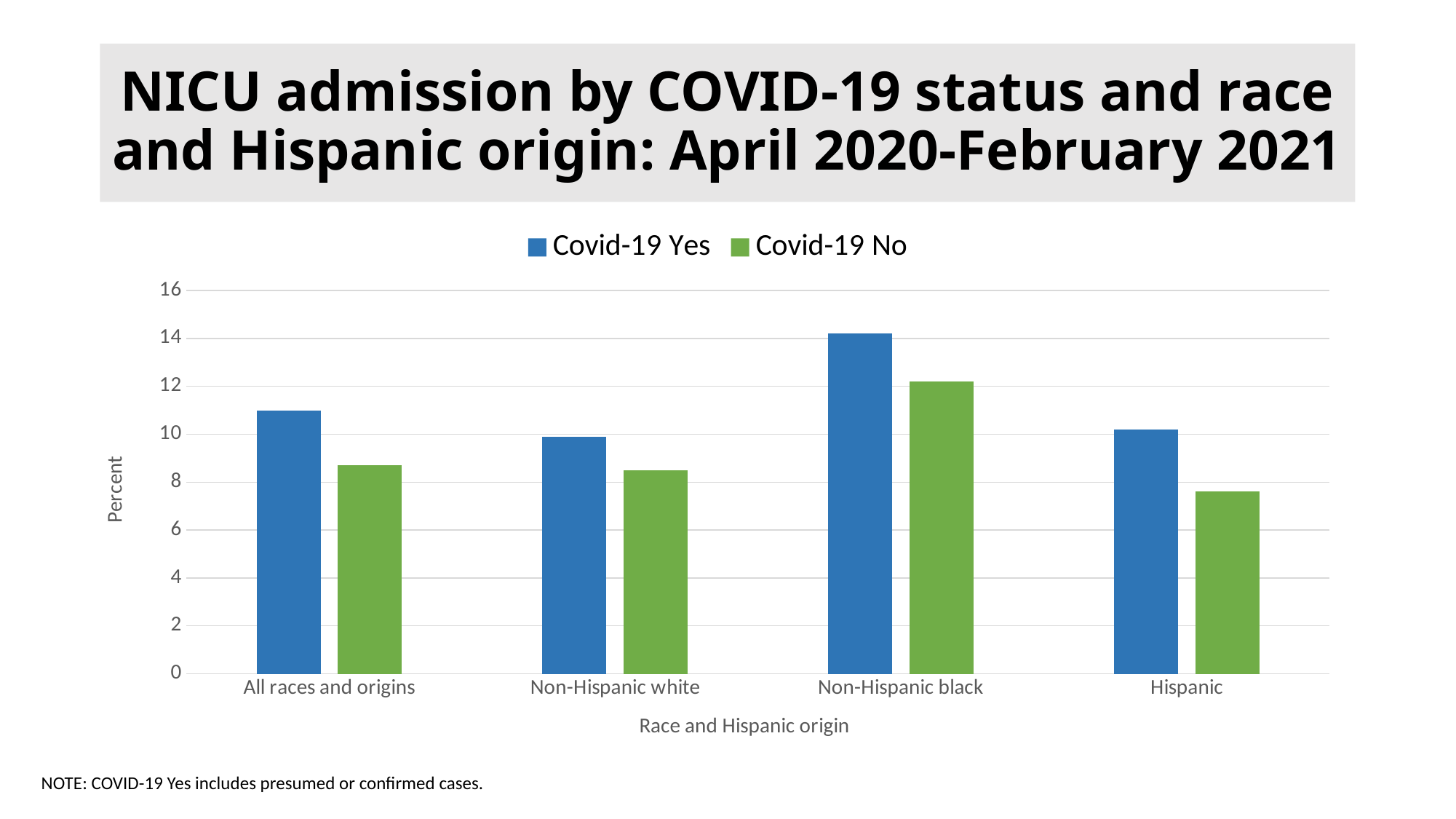
Is the Covid-19 Yes value for Non-Hispanic black greater or less than 12? greater What is the label of the y axis? Percent Which category has the highest value for Covid-19 Yes? Non-Hispanic black How many series does the legend list? 2 For Non-Hispanic black, which is larger: Covid-19 Yes or Covid-19 No? Covid-19 Yes How many race and Hispanic origin categories are shown on the x axis? 4 Is the Covid-19 No value for Hispanic greater or less than 8? less Is the Covid-19 No value for Non-Hispanic white greater or less than 10? less What kind of chart is shown on the slide? Bar chart Which category has the highest value for Covid-19 No? Non-Hispanic black Which category has the lowest value for Covid-19 No? Hispanic